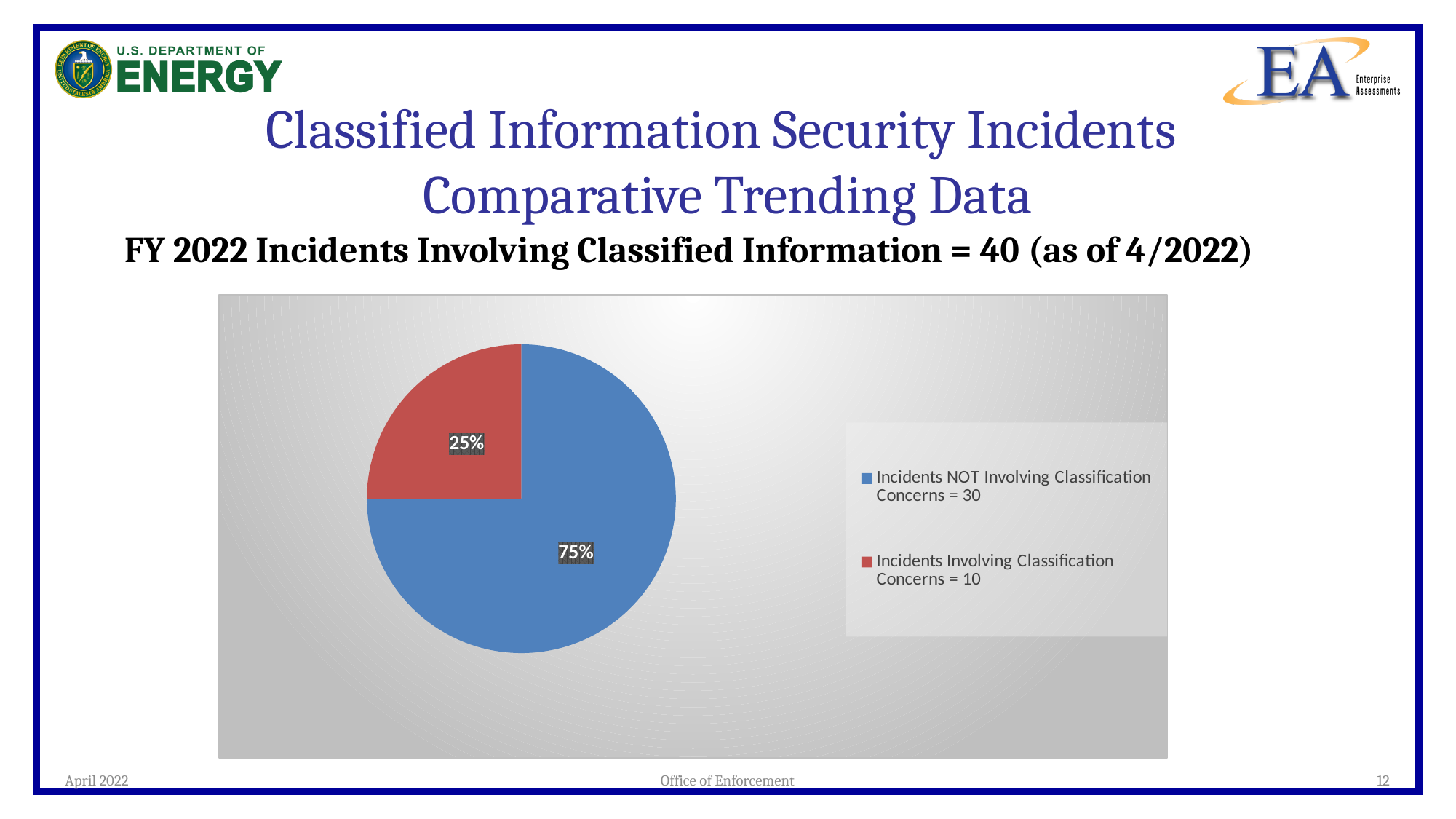
What percentage of the pie is labelled for Incidents Involving Classification Concerns? 25% According to the legend, how many incidents did NOT involve classification concerns? 30 What percentage of the pie is labelled for Incidents NOT Involving Classification Concerns? 75% Which slice is the smallest in the pie chart? Incidents Involving Classification Concerns What is the difference in percentage points between the 75% slice and the 25% slice? 50 percentage points According to the legend, how many incidents involved classification concerns? 10 Which is larger: the share of incidents involving classification concerns or the share not involving classification concerns? Incidents NOT Involving Classification Concerns Which slice is the largest in the pie chart? Incidents NOT Involving Classification Concerns What kind of chart is shown on the slide? pie chart What colour is the slice for Incidents Involving Classification Concerns? red How many slices does the pie chart have? 2 How many entries does the legend list? 2